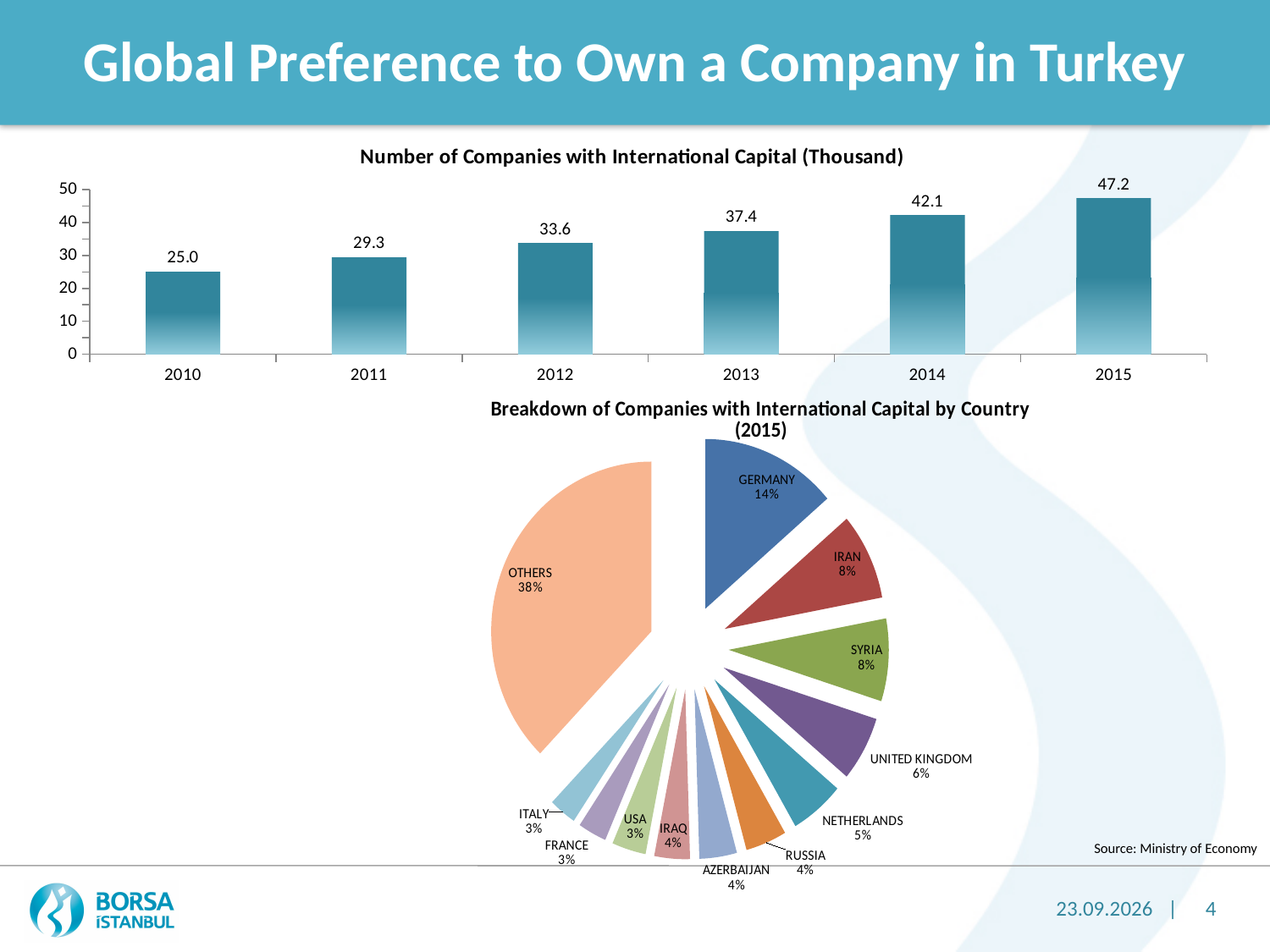
In the pie chart 'Breakdown of Companies with International Capital by Country (2015)', what share does the United Kingdom have? 6% How many years are shown in the bar chart 'Number of Companies with International Capital (Thousand)'? 6 What kind of chart is 'Breakdown of Companies with International Capital by Country (2015)'? pie chart In the pie chart 'Breakdown of Companies with International Capital by Country (2015)', which is larger, the share for Netherlands or the share for Iran? Iran In the bar chart 'Number of Companies with International Capital (Thousand)', do the values rise or fall from 2010 to 2015? rise In the bar chart 'Number of Companies with International Capital (Thousand)', which year has the highest value? 2015 In the bar chart 'Number of Companies with International Capital (Thousand)', what is the difference between the 2015 and 2014 values? 5.1 What kind of chart is 'Number of Companies with International Capital (Thousand)'? bar chart In the pie chart 'Breakdown of Companies with International Capital by Country (2015)', which slice is the largest? OTHERS In the bar chart 'Number of Companies with International Capital (Thousand)', what is the value for 2010? 25.0 In the pie chart 'Breakdown of Companies with International Capital by Country (2015)', what share does Germany have? 14% In the bar chart 'Number of Companies with International Capital (Thousand)', what is the value for 2013? 37.4